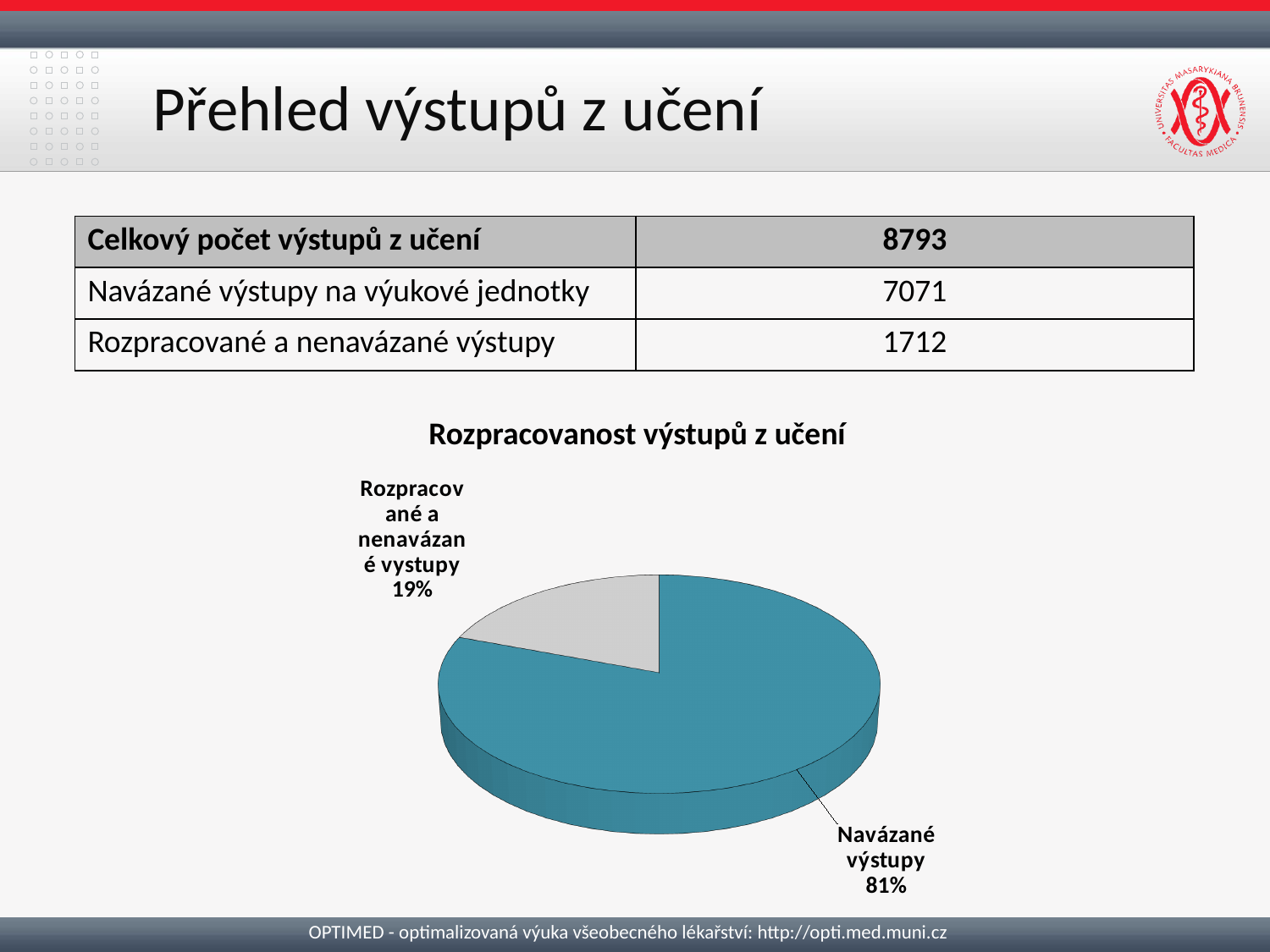
Which is larger: the "Navázané výstupy" slice or the "Rozpracované a nenavázané výstupy" slice? Navázané výstupy What is the difference in percentage points between the "Navázané výstupy" slice and the "Rozpracované a nenavázané výstupy" slice? 62 percentage points Which slice of the pie is the largest? Navázané výstupy What is the title of the chart? Rozpracovanost výstupů z učení What kind of chart is shown on the slide? pie chart What share of the pie is labelled "Rozpracované a nenavázané výstupy"? 19% What share of the pie is labelled "Navázané výstupy"? 81% Which slice of the pie is the smallest? Rozpracované a nenavázané výstupy What colour is the "Navázané výstupy" slice of the pie? teal blue How many slices does the pie chart have? 2